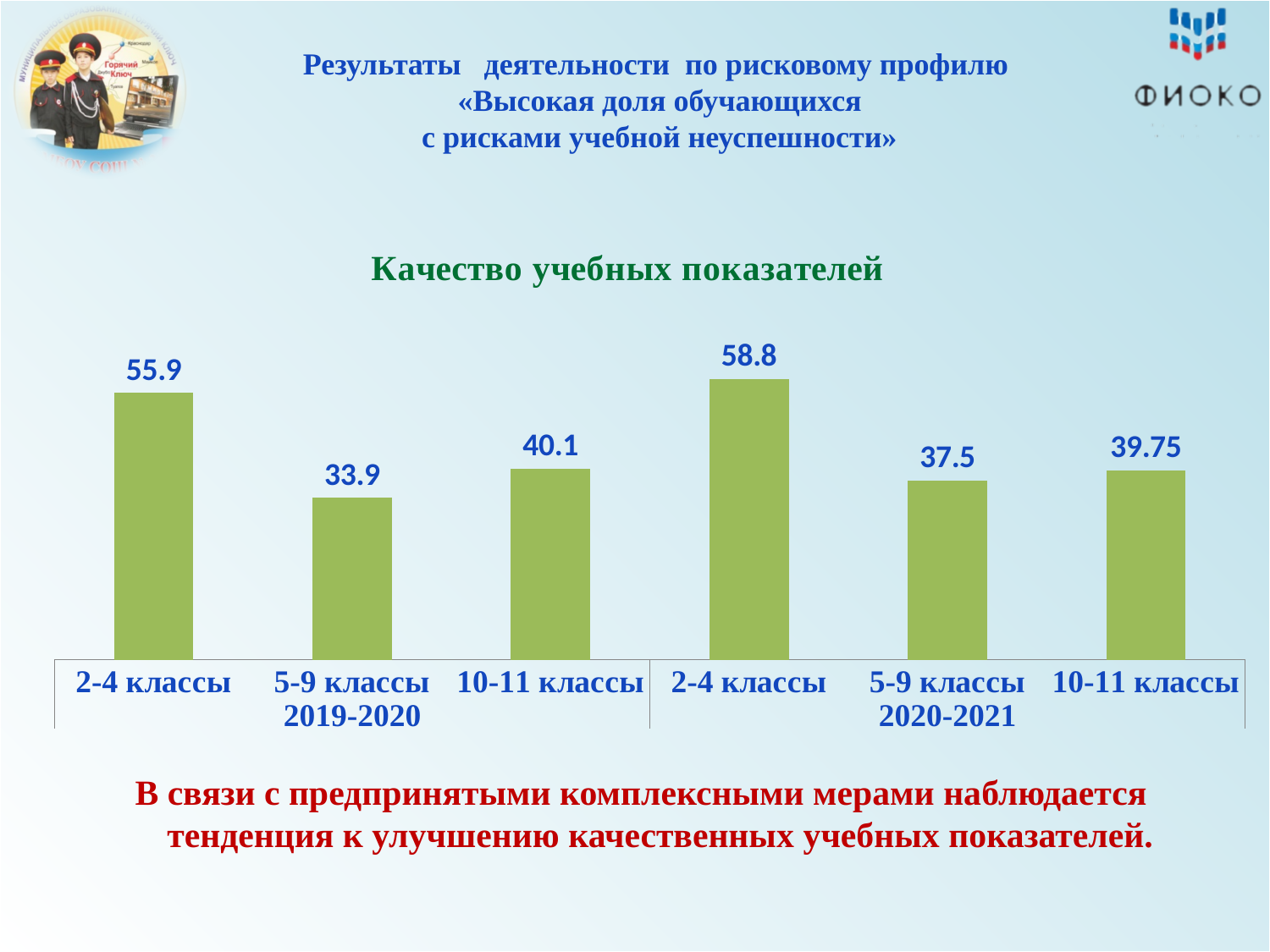
How many bars are plotted on the chart? 6 What is the value for 5-9 классы in 2020-2021? 37.5 What type of chart is shown on the slide? Bar chart What is the value for 2-4 классы in 2019-2020? 55.9 What is the value for 10-11 классы in 2019-2020? 40.1 Which bar has the highest value on the chart? 2-4 классы 2020-2021 What is the title of the chart? Качество учебных показателей What is the difference between the 5-9 классы values for 2020-2021 and 2019-2020? 3.6 Which is larger: the value for 5-9 классы in 2019-2020 or in 2020-2021? 2020-2021 What is the value for 10-11 классы in 2020-2021? 39.75 What is the difference between the 2-4 классы values for 2020-2021 and 2019-2020? 2.9 Which bar has the lowest value on the chart? 5-9 классы 2019-2020